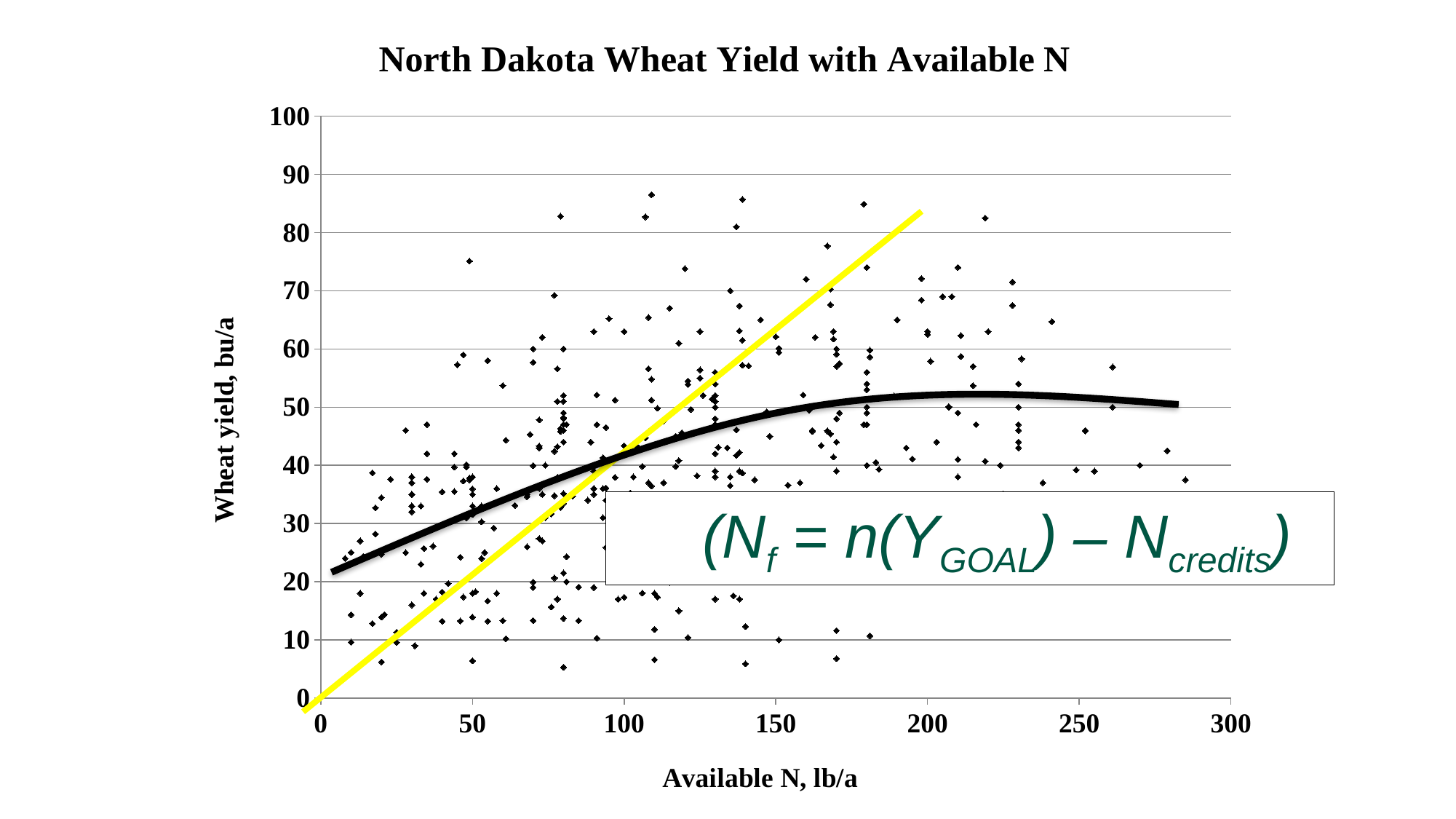
Does the black fitted curve rise or fall as Available N increases from 0 to 200 lb/a? rise Is the value of the yellow line at 150 lb/a Available N greater or less than 50 bu/a? greater What is the highest value shown on the x axis? 300 Is the peak of the black fitted curve greater or less than 50 bu/a? greater Is the value of the black fitted curve at 50 lb/a Available N greater or less than 40 bu/a? less What kind of chart is shown on the slide? scatter plot What is the highest value shown on the y axis? 100 Which line is higher at 50 lb/a Available N, the black curve or the yellow line? the black curve Which line is higher at 150 lb/a Available N, the black curve or the yellow line? the yellow line What is the title of the chart? North Dakota Wheat Yield with Available N What is the label of the x axis? Available N, lb/a